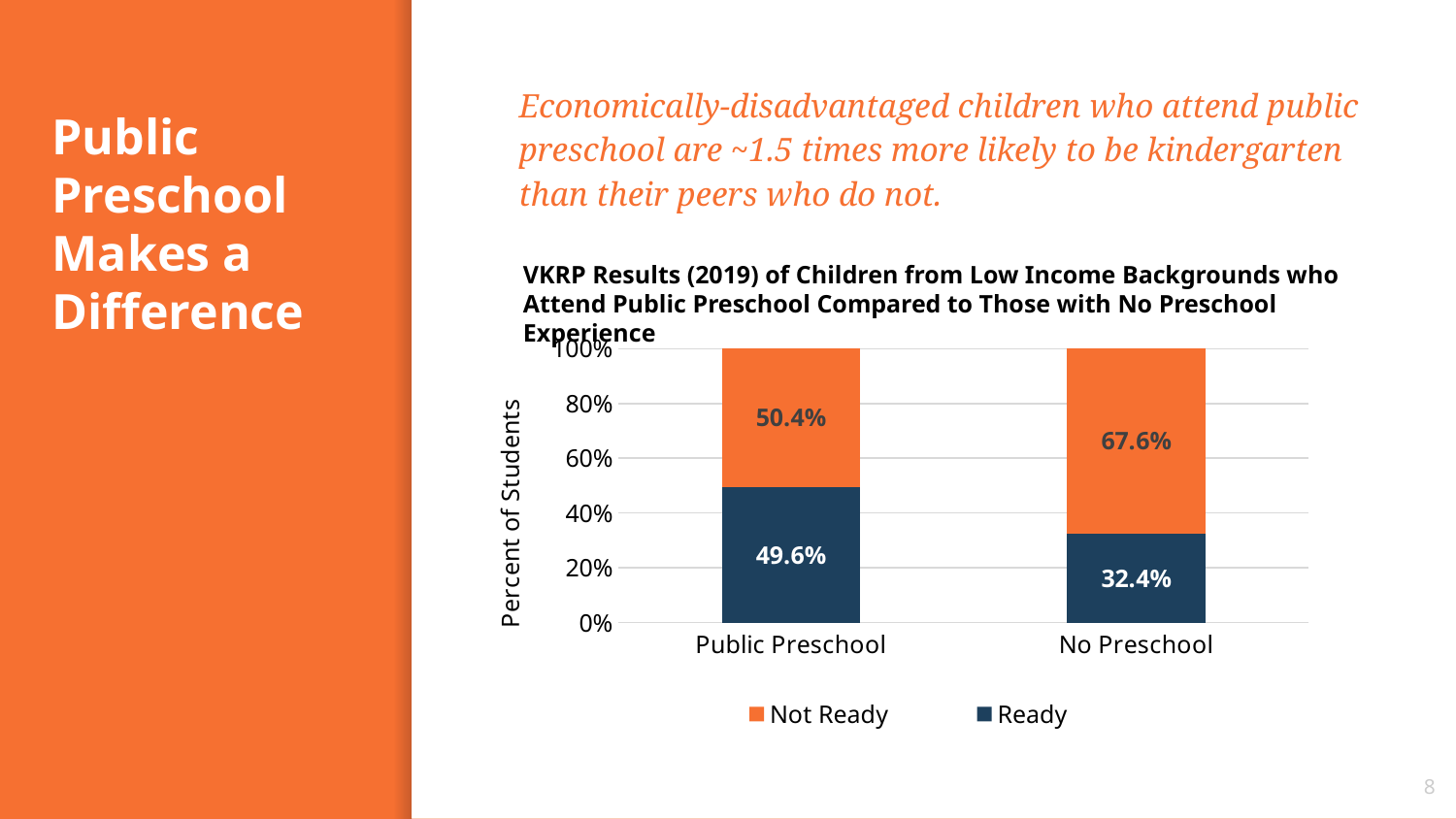
How many categories are shown on the x axis? 2 What percentage of Public Preschool students are Ready? 49.6% Which category has the higher Ready percentage? Public Preschool What is the Not Ready value for Public Preschool? 50.4% What is the label on the vertical axis? Percent of Students Which category has the lower Not Ready percentage? Public Preschool What percentage of No Preschool students are Not Ready? 67.6% What is the Ready value for No Preschool? 32.4% Is the Not Ready value larger for Public Preschool or No Preschool? No Preschool What is the difference between the Ready percentages for Public Preschool and No Preschool? 17.2% What kind of chart is shown? Stacked bar chart How many series does the legend list? 2